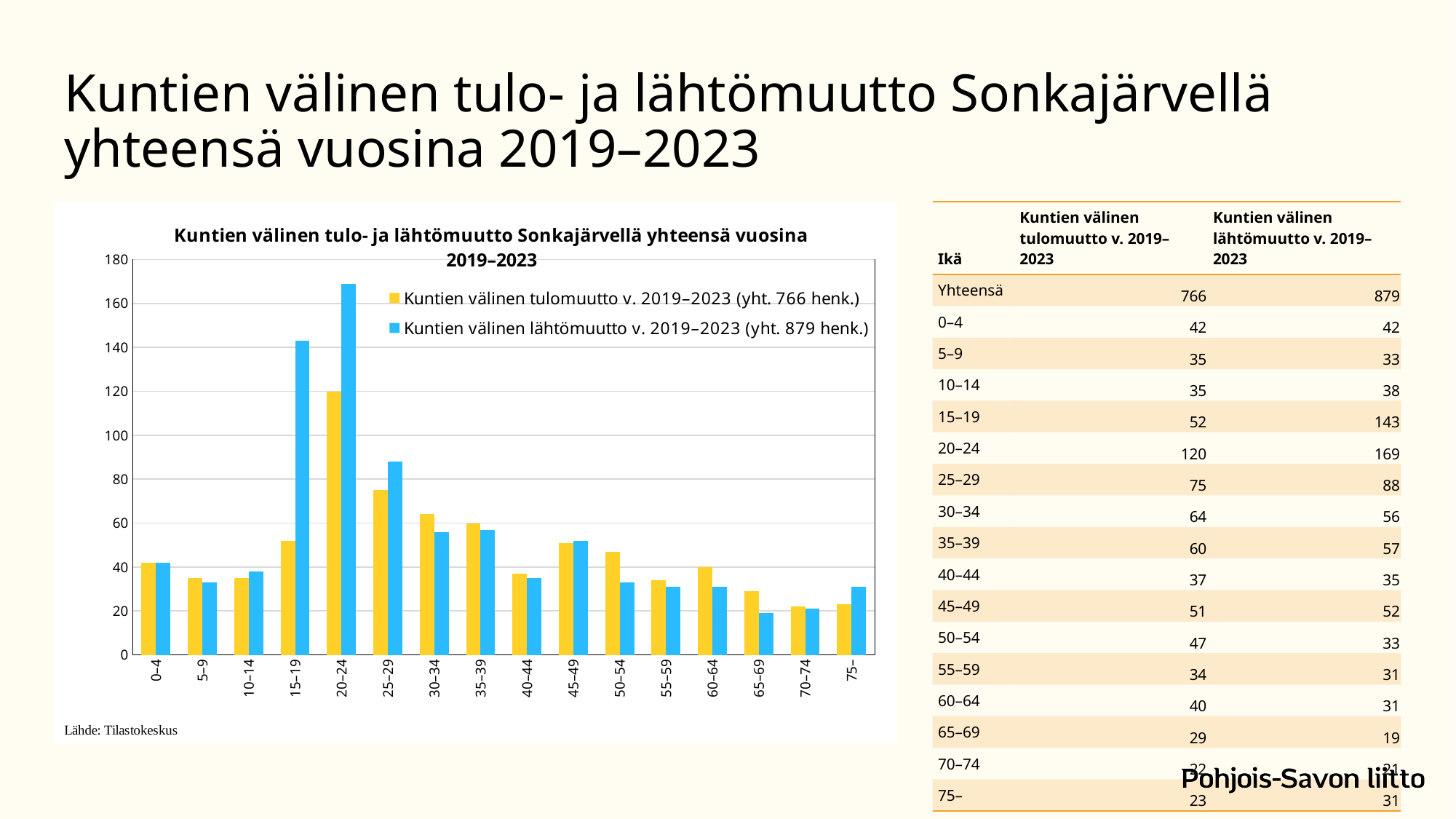
Which age group has the lowest value for Kuntien välinen lähtömuutto v. 2019–2023? 65–69 According to the legend, what is the total number of people for Kuntien välinen lähtömuutto v. 2019–2023? 879 henk. What is the difference between lähtömuutto (169) and tulomuutto (120) for the 20–24 age group, as given in the table? 49 How many series does the chart's legend list? 2 Which age group has the highest value for Kuntien välinen lähtömuutto v. 2019–2023? 20–24 Which age group has the highest value for Kuntien välinen tulomuutto v. 2019–2023? 20–24 According to the legend, what is the total number of people for Kuntien välinen tulomuutto v. 2019–2023? 766 henk. What colour are the bars for Kuntien välinen tulomuutto v. 2019–2023? yellow For the 30–34 age group, which is larger: tulomuutto or lähtömuutto? tulomuutto Is the lähtömuutto value for the 15–19 age group greater or less than 140? greater What kind of chart is shown on the slide? bar chart How many age groups are shown on the x axis of the chart? 16